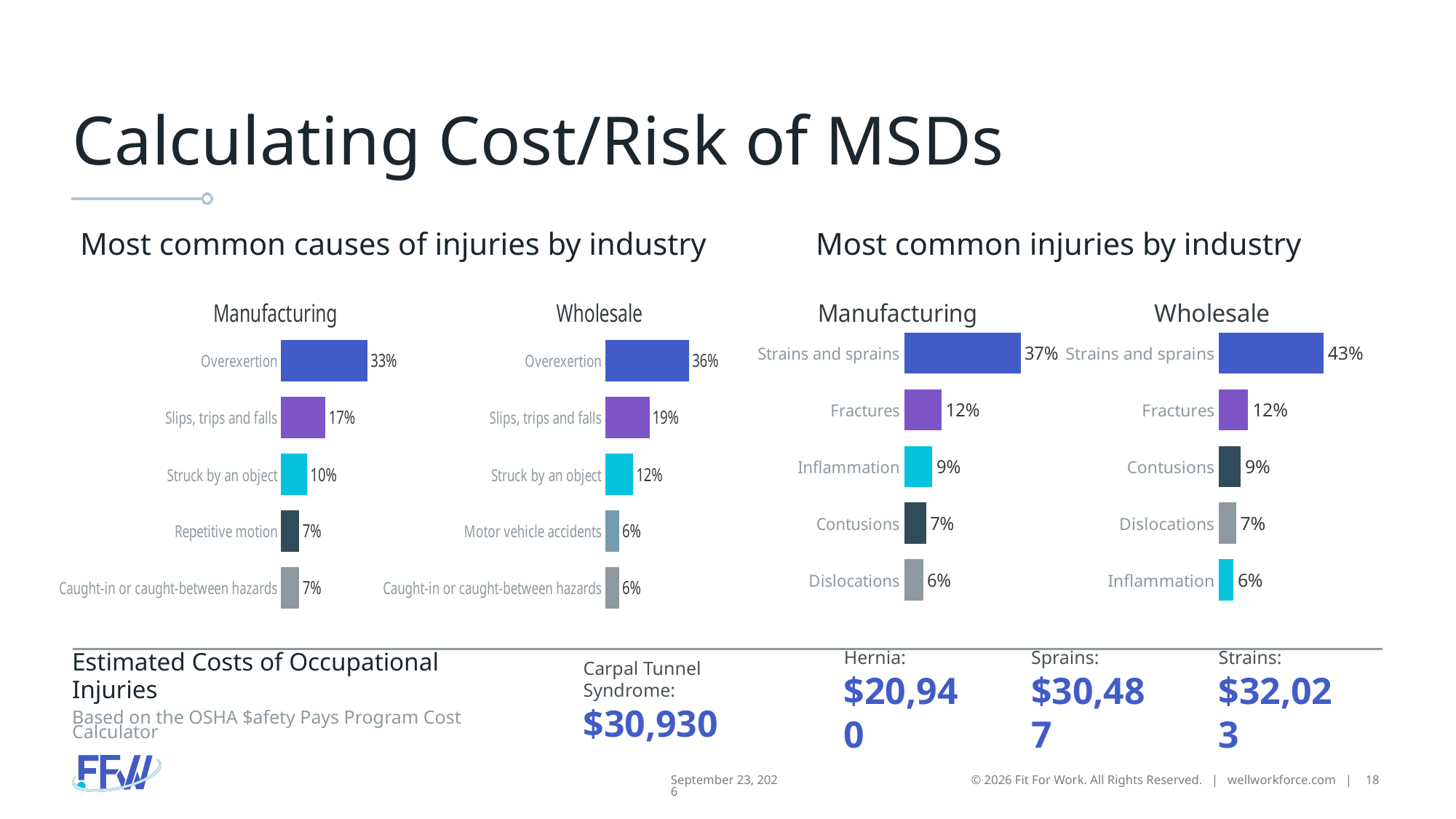
In the Wholesale chart under 'Most common injuries by industry', what is the value for Strains and sprains? 43% What kind of chart is used for the Manufacturing chart under 'Most common injuries by industry'? Bar chart How many categories are shown in the Wholesale chart under 'Most common causes of injuries by industry'? 5 Which is larger: Overexertion in the Manufacturing causes chart or Overexertion in the Wholesale causes chart? Wholesale (36%) In the Wholesale chart under 'Most common causes of injuries by industry', what is the value for Slips, trips and falls? 19% In the Manufacturing chart under 'Most common injuries by industry', which category has the highest value? Strains and sprains In the Wholesale chart under 'Most common injuries by industry', which category has the lowest value? Inflammation In the Manufacturing chart under 'Most common injuries by industry', what is the value for Inflammation? 9% In the Manufacturing chart under 'Most common causes of injuries by industry', what is the value for Overexertion? 33% In the Manufacturing chart under 'Most common causes of injuries by industry', what is the difference between Overexertion and Slips, trips and falls? 16% In the Wholesale chart under 'Most common causes of injuries by industry', what is the value for Motor vehicle accidents? 6% What is the difference between Strains and sprains in the Wholesale injuries chart and Strains and sprains in the Manufacturing injuries chart? 6%